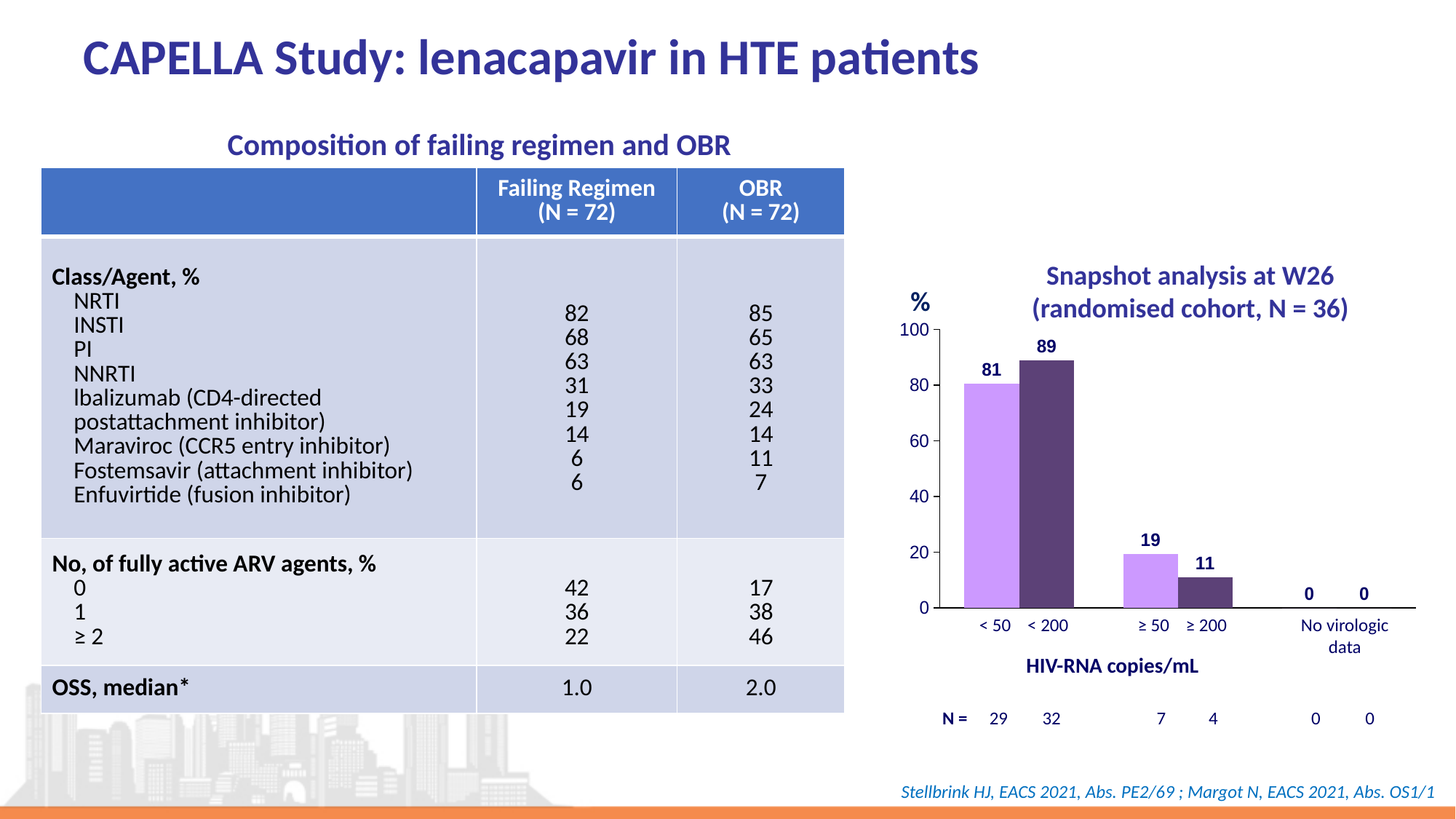
In the Snapshot analysis at W26 chart, what is the label of the x axis? HIV-RNA copies/mL In the Snapshot analysis at W26 chart, which is larger, the value for < 50 or the value for ≥ 50? < 50 In the Snapshot analysis at W26 chart, which bar has the highest value? < 200 In the Snapshot analysis at W26 chart, what is the value for HIV-RNA ≥ 50 copies/mL? 19 In the Snapshot analysis at W26 chart, what is the value for HIV-RNA ≥ 200 copies/mL? 11 What kind of chart is the Snapshot analysis at W26 chart? Bar chart In the Snapshot analysis at W26 chart, what is the difference between the ≥ 50 and ≥ 200 bars? 8 In the Snapshot analysis at W26 chart, what is the difference between the < 200 and < 50 bars? 8 In the Snapshot analysis at W26 chart, what percentage of patients had HIV-RNA < 50 copies/mL? 81 In the Snapshot analysis at W26 chart, what percentage of patients had HIV-RNA < 200 copies/mL? 89 In the Snapshot analysis at W26 chart, is the value for < 50 greater or less than 60? greater In the Snapshot analysis at W26 chart, how many bars are plotted? 4